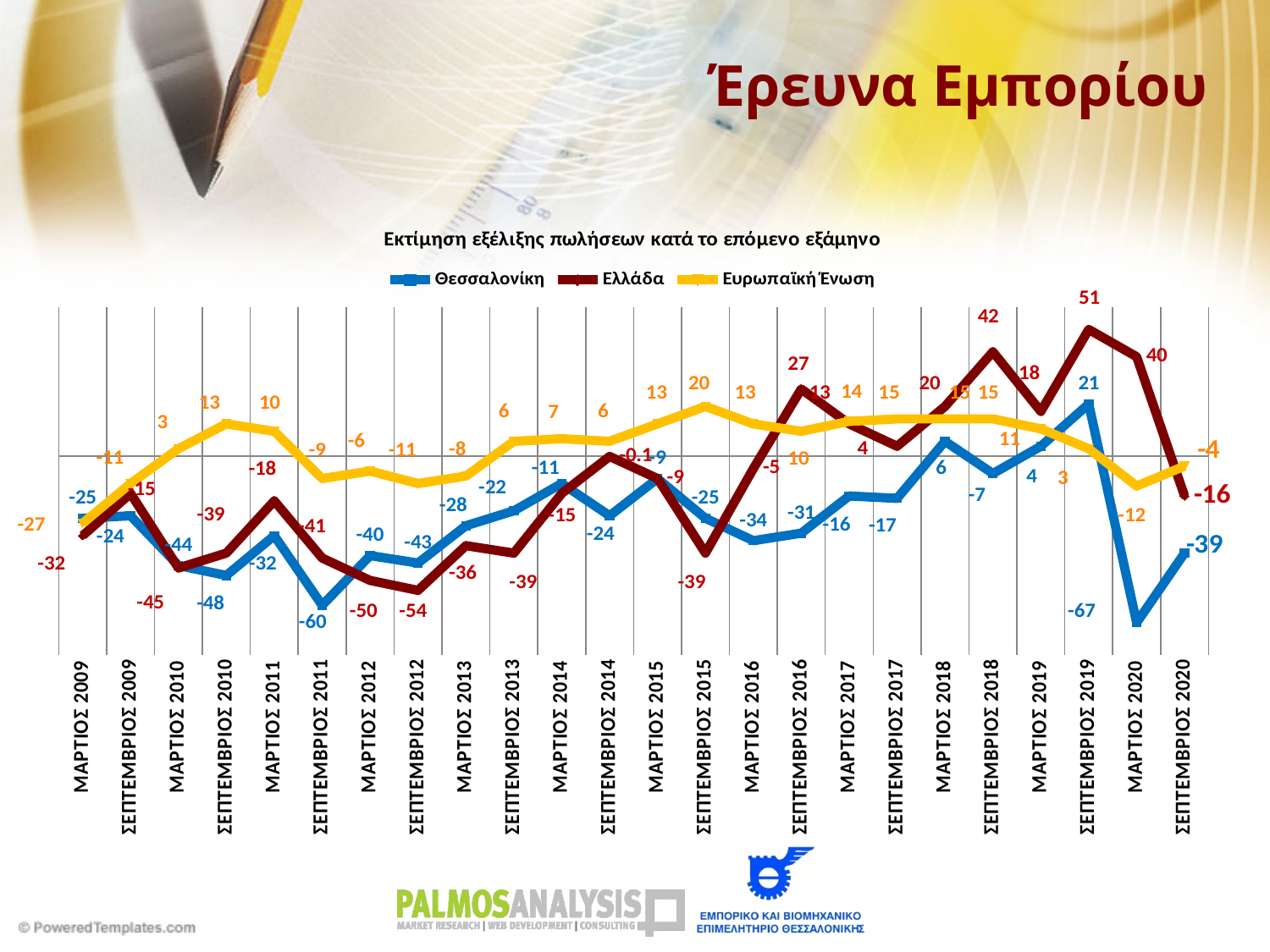
What is the value for Ελλάδα at ΣΕΠΤΕΜΒΡΙΟΣ 2020? -16 What is the title of the chart? Εκτίμηση εξέλιξης πωλήσεων κατά το επόμενο εξάμηνο What is the value for Θεσσαλονίκη at ΣΕΠΤΕΜΒΡΙΟΣ 2020? -39 What kind of chart is shown on the slide? line chart What is the lowest value of the Θεσσαλονίκη series? -67 What is the difference between the Ελλάδα and Θεσσαλονίκη values at ΣΕΠΤΕΜΒΡΙΟΣ 2020? 23 How many time points are plotted along the x axis? 24 At ΜΑΡΤΙΟΣ 2020, which series has the larger value, Ελλάδα or Θεσσαλονίκη? Ελλάδα How many series does the legend list? 3 What is the lowest value of the Ελλάδα series? -54 What is the value for Ευρωπαϊκή Ένωση at ΜΑΡΤΙΟΣ 2009? -27 At which time point does the Ελλάδα series reach its highest value? ΣΕΠΤΕΜΒΡΙΟΣ 2019